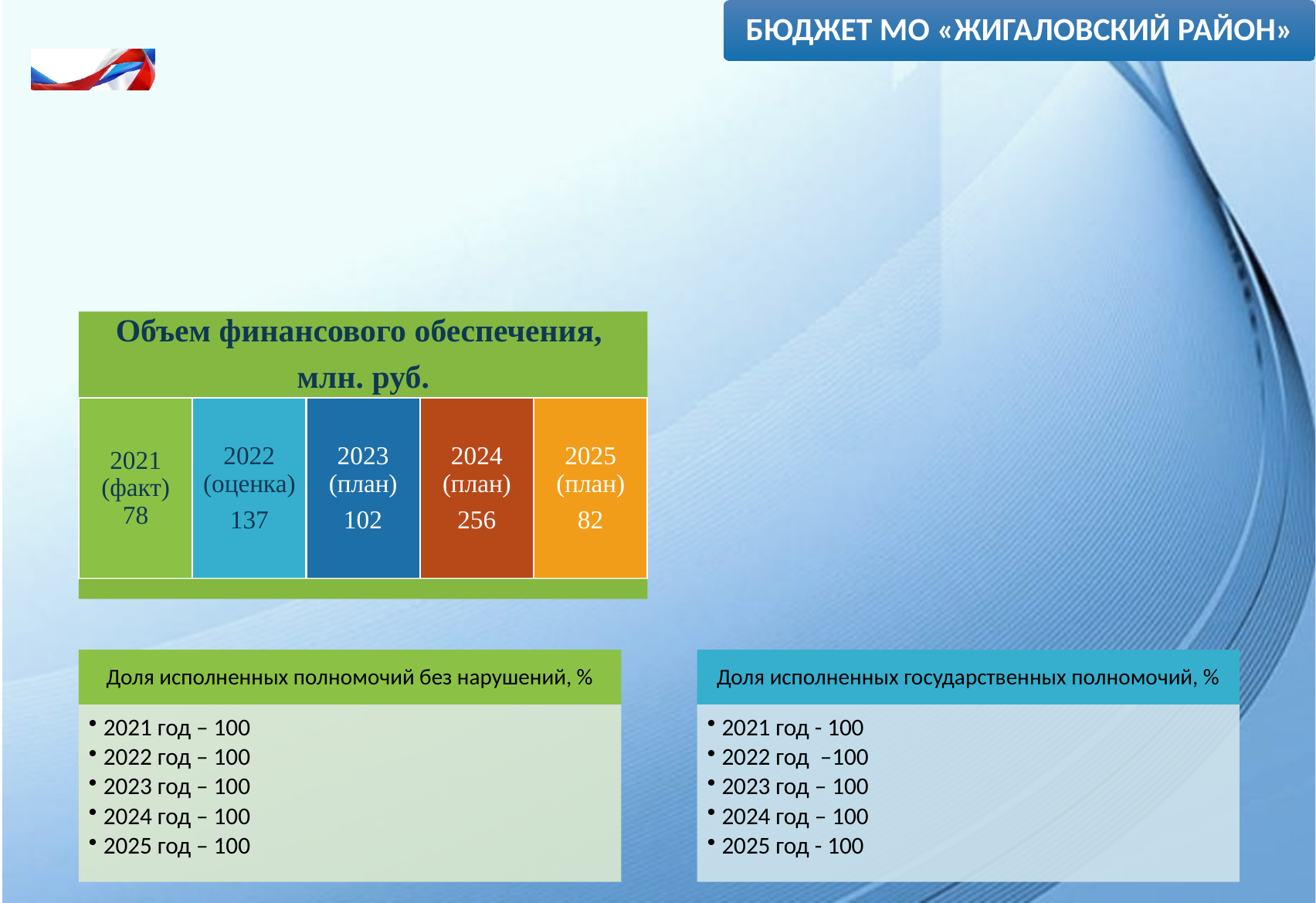
In the "Объем финансового обеспечения, млн. руб." graphic, which is larger: the value for 2022 (оценка) or for 2025 (план)? 2022 (оценка) In the "Объем финансового обеспечения, млн. руб." graphic, what is the value for 2025 (план)? 82 In the "Объем финансового обеспечения, млн. руб." graphic, what is the value for 2021 (факт)? 78 How many years are shown in the "Объем финансового обеспечения, млн. руб." graphic? 5 What colour is the block for 2024 (план) in the "Объем финансового обеспечения, млн. руб." graphic? Brown (dark orange-red) In the "Объем финансового обеспечения, млн. руб." graphic, what is the difference between the 2022 (оценка) and 2021 (факт) values? 59 In the "Объем финансового обеспечения, млн. руб." graphic, which year has the highest value? 2024 (план) In the "Объем финансового обеспечения, млн. руб." graphic, what is the value for 2023 (план)? 102 In the "Объем финансового обеспечения, млн. руб." graphic, what is the value for 2024 (план)? 256 In the "Объем финансового обеспечения, млн. руб." graphic, what is the difference between the 2024 (план) and 2023 (план) values? 154 In the "Объем финансового обеспечения, млн. руб." graphic, what is the value for 2022 (оценка)? 137 In the "Объем финансового обеспечения, млн. руб." graphic, which year has the lowest value? 2021 (факт)